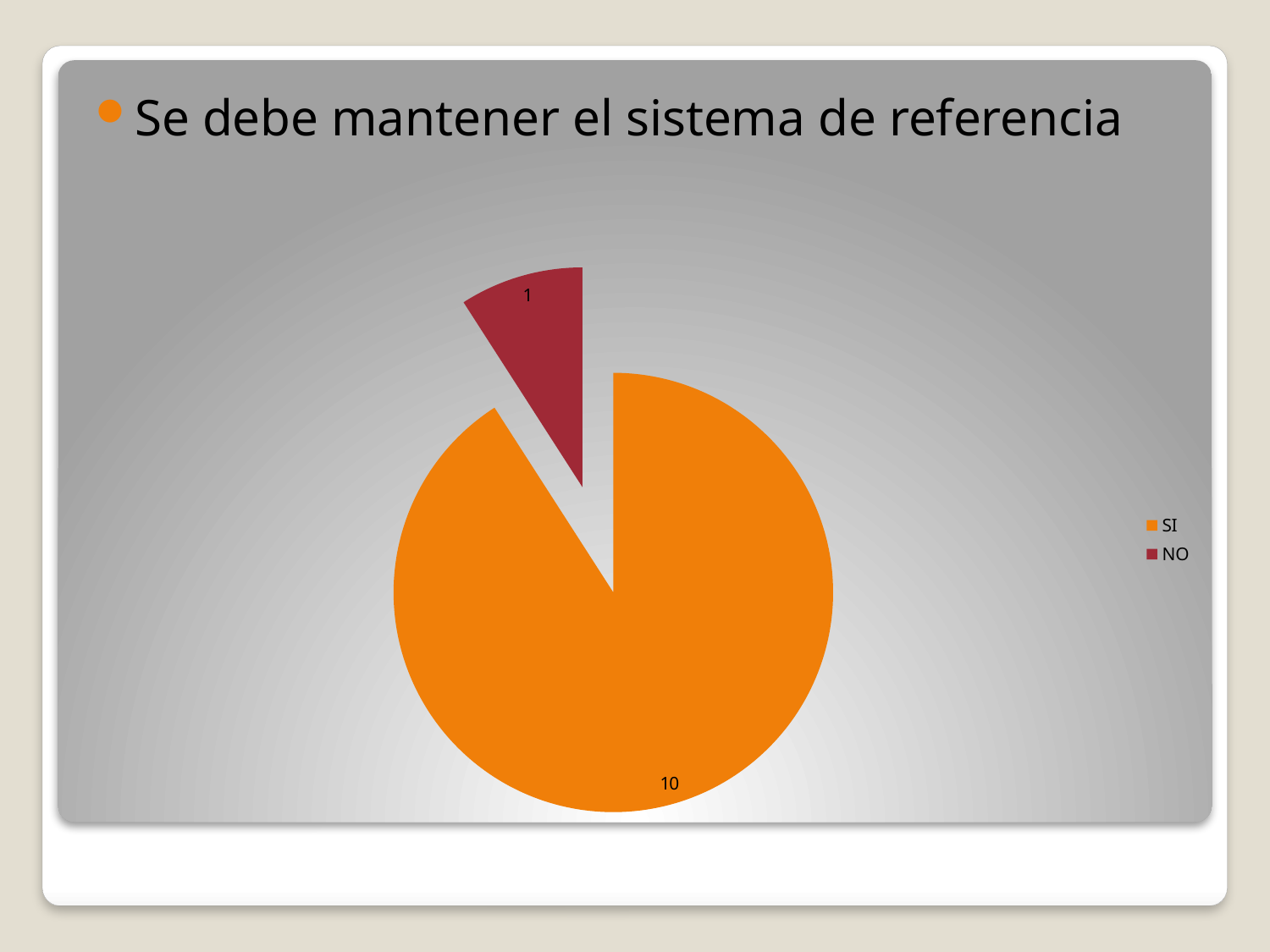
How many entries does the legend of the chart list? 2 What kind of chart is shown on the slide? Pie chart What is the text of the heading above the pie chart? Se debe mantener el sistema de referencia What colour is the SI slice in the pie chart? Orange Which category has the smallest slice in the pie chart? NO What is the value of the NO slice in the pie chart? 1 What is the difference between the SI and NO values in the pie chart? 9 What is the total of all slices in the pie chart? 11 How many slices does the pie chart have? 2 What is the value of the SI slice in the pie chart? 10 Which is larger in the pie chart, SI or NO? SI Which category has the largest slice in the pie chart? SI